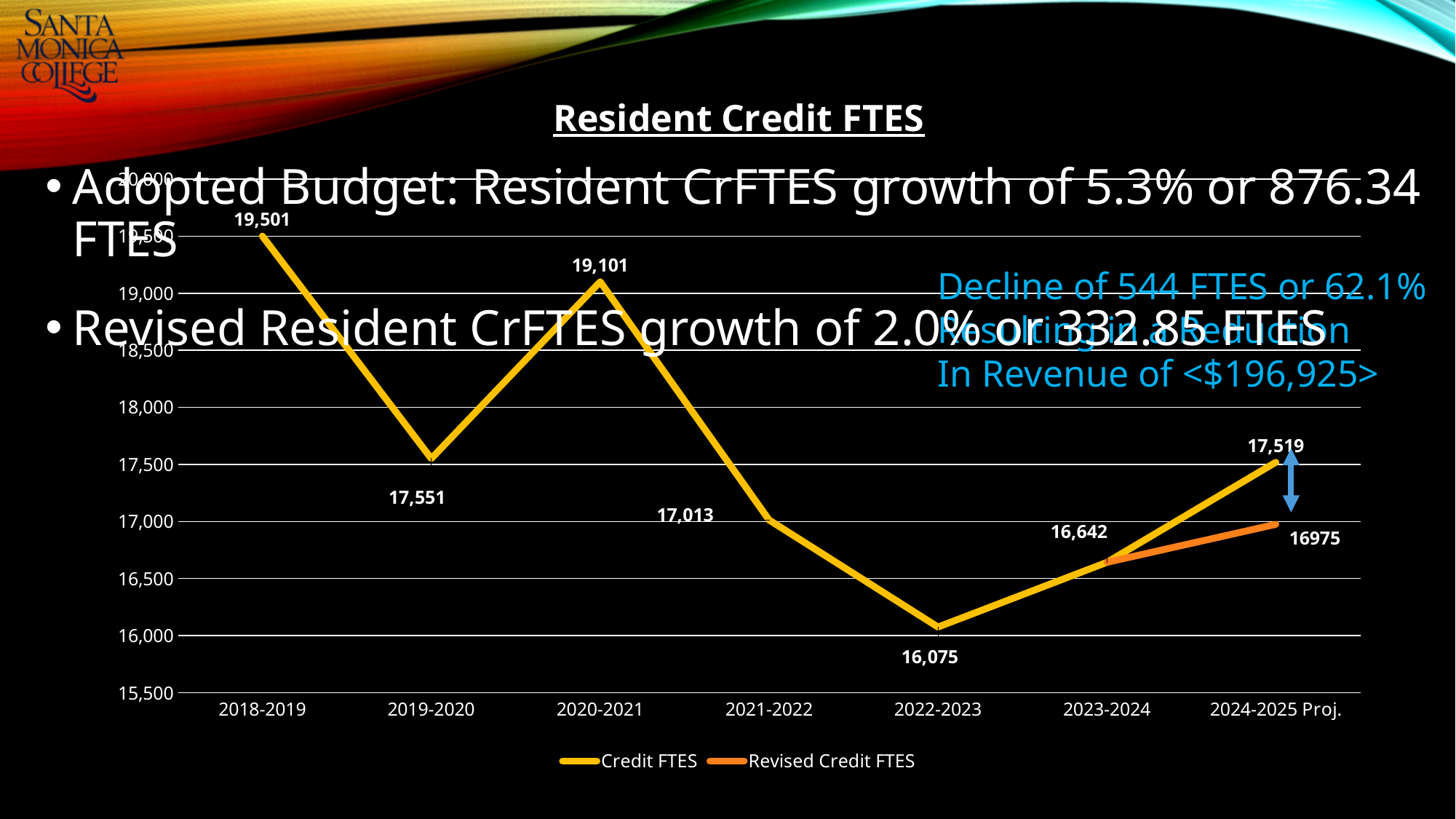
What is the Credit FTES value for 2022-2023? 16,075 What is the Revised Credit FTES value for 2024-2025 Proj.? 16975 Does the Credit FTES line rise or fall from 2022-2023 to 2024-2025 Proj.? Rise What is the Credit FTES value for 2018-2019? 19,501 How many series does the legend list? 2 How many years are shown on the x axis? 7 Which is larger, the Credit FTES value for 2021-2022 or for 2023-2024? 2021-2022 What is the difference between the Credit FTES value for 2020-2021 and 2019-2020? 1,550 What is the difference between the Credit FTES and Revised Credit FTES values for 2024-2025 Proj.? 544 Which year has the lowest Credit FTES value? 2022-2023 What type of chart is shown on the slide? Line chart Which year has the highest Credit FTES value? 2018-2019